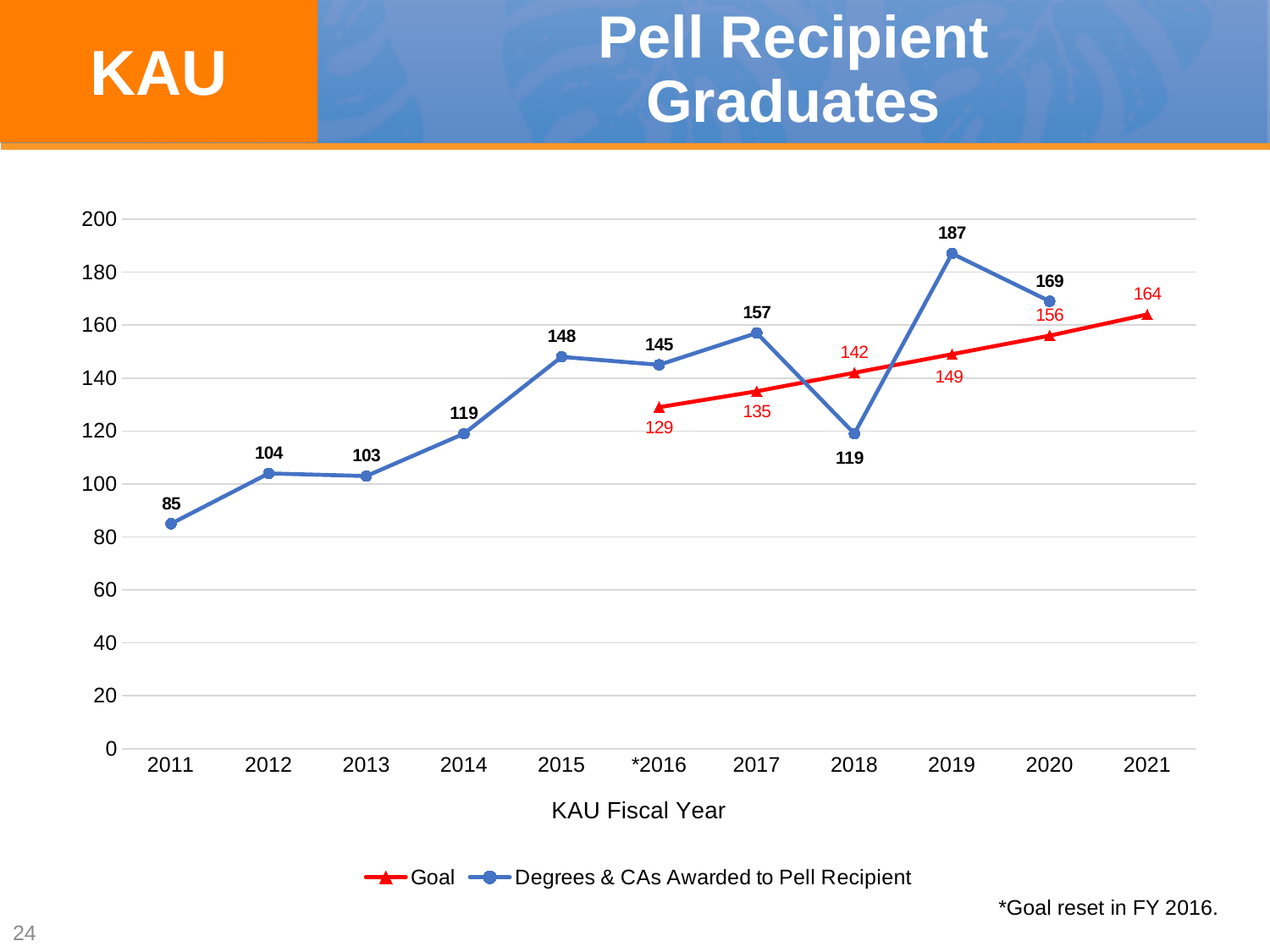
What is the difference between the Degrees & CAs Awarded to Pell Recipient value in 2019 and in 2020? 18 How many series does the legend list? 2 What kind of chart is shown on the slide? Line chart Is the Degrees & CAs Awarded to Pell Recipient value for 2015 greater or less than 140? greater In which year is the Degrees & CAs Awarded to Pell Recipient value highest? 2019 How many fiscal years are shown on the x axis? 11 Does the Goal series rise or fall from *2016 to 2021? Rise In which year is the Degrees & CAs Awarded to Pell Recipient value lowest? 2011 What is the Goal value for 2021? 164 What is the value of Degrees & CAs Awarded to Pell Recipient in 2011? 85 What is the value of Degrees & CAs Awarded to Pell Recipient in 2019? 187 In 2018, which is larger: the Goal or the Degrees & CAs Awarded to Pell Recipient value? Goal